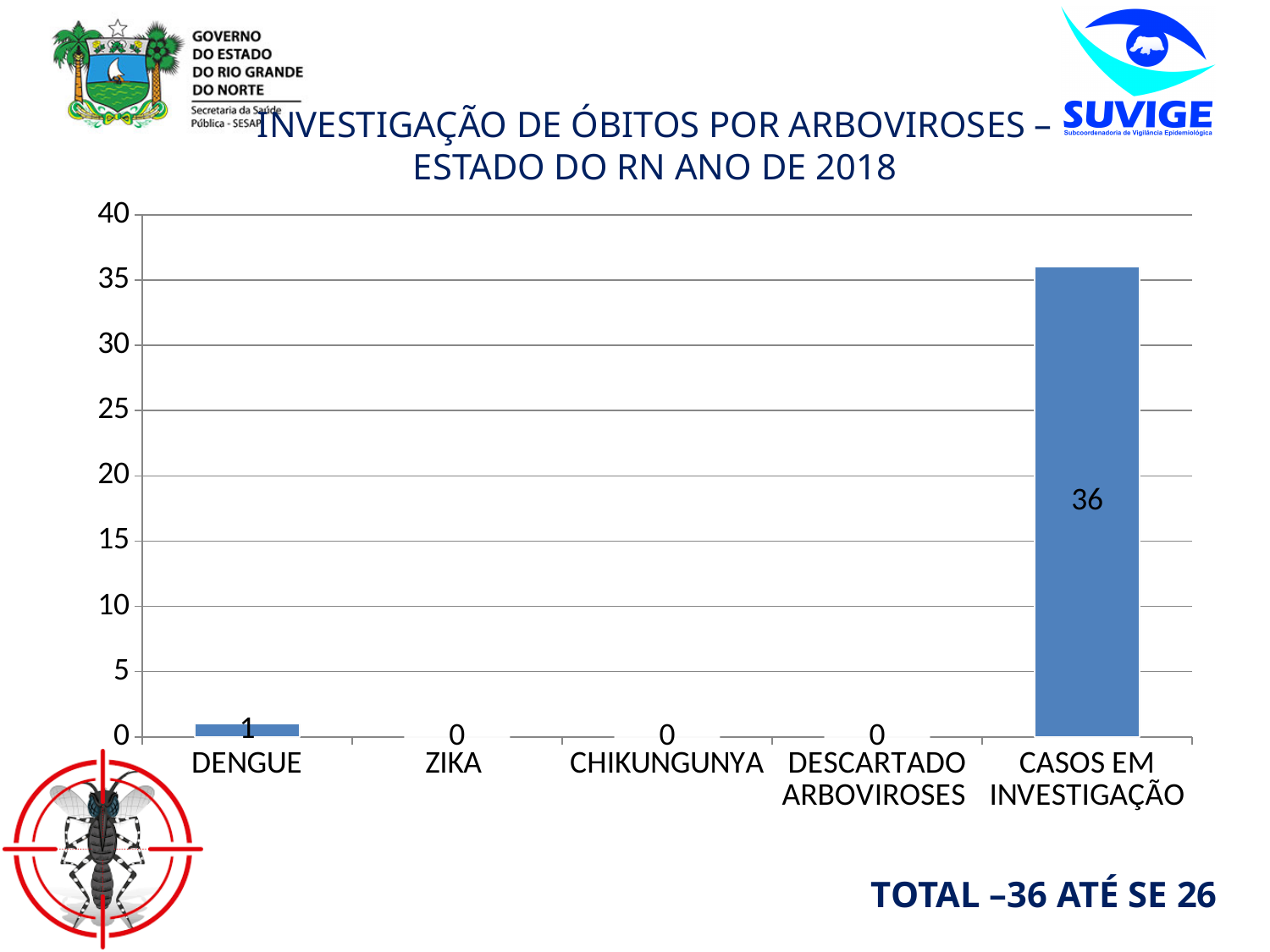
What is the value for CASOS EM INVESTIGAÇÃO? 36 What is the value for DESCARTADO ARBOVIROSES? 0 Which is larger, the value for DENGUE or the value for CHIKUNGUNYA? DENGUE What is the difference between the values for CASOS EM INVESTIGAÇÃO and DENGUE? 35 How many categories have a value of 0? 3 What is the title of the chart? INVESTIGAÇÃO DE ÓBITOS POR ARBOVIROSES – ESTADO DO RN ANO DE 2018 What kind of chart is shown on the slide? bar chart What is the value for DENGUE? 1 Which category has the highest value? CASOS EM INVESTIGAÇÃO How many categories are shown on the x axis? 5 What is the value for ZIKA? 0 Is the value for CASOS EM INVESTIGAÇÃO greater or less than 30? greater